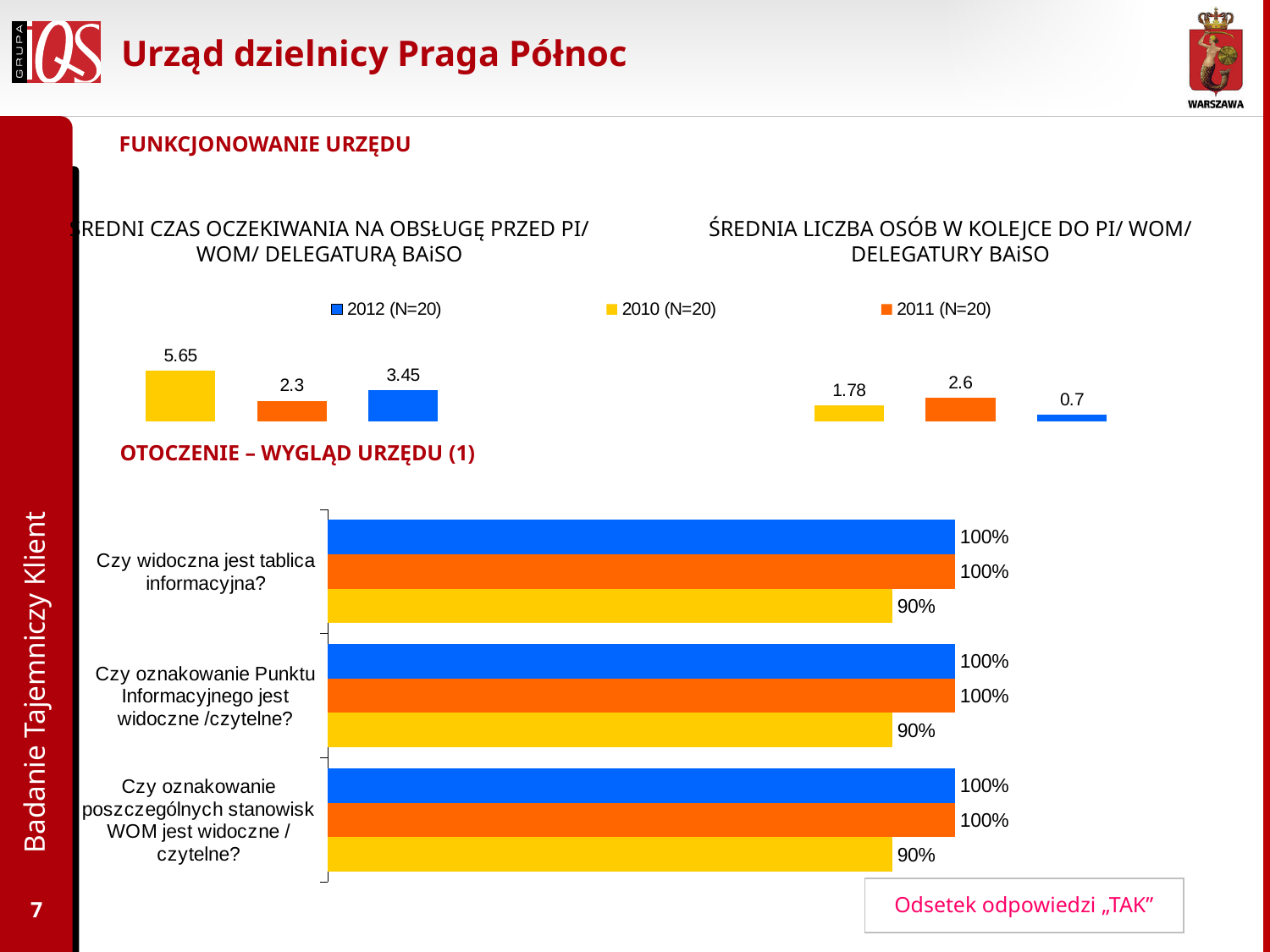
In the chart titled "ŚREDNIA LICZBA OSÓB W KOLEJCE DO PI/ WOM/ DELEGATURY BAiSO", what is the difference between the 2011 value and the 2012 value? 1.9 In the chart titled "ŚREDNI CZAS OCZEKIWANIA NA OBSŁUGĘ PRZED PI/ WOM/ DELEGATURĄ BAiSO", what is the difference between the 2010 value and the 2011 value? 3.35 In the bottom chart under "OTOCZENIE – WYGLĄD URZĘDU (1)", what is the value for 2010 (N=20) for "Czy widoczna jest tablica informacyjna?"? 90% In the chart titled "ŚREDNI CZAS OCZEKIWANIA NA OBSŁUGĘ PRZED PI/ WOM/ DELEGATURĄ BAiSO", what is the value for 2012 (N=20)? 3.45 In the chart titled "ŚREDNIA LICZBA OSÓB W KOLEJCE DO PI/ WOM/ DELEGATURY BAiSO", is the value for 2010 larger or smaller than the value for 2012? larger In the chart titled "ŚREDNI CZAS OCZEKIWANIA NA OBSŁUGĘ PRZED PI/ WOM/ DELEGATURĄ BAiSO", what is the value for 2010 (N=20)? 5.65 In the chart titled "ŚREDNIA LICZBA OSÓB W KOLEJCE DO PI/ WOM/ DELEGATURY BAiSO", what is the value for 2011 (N=20)? 2.6 What type of chart is the bottom chart under "OTOCZENIE – WYGLĄD URZĘDU (1)"? bar chart How many question categories are shown in the bottom chart under "OTOCZENIE – WYGLĄD URZĘDU (1)"? 3 In the bottom chart under "OTOCZENIE – WYGLĄD URZĘDU (1)", what is the value for 2012 (N=20) for "Czy oznakowanie Punktu Informacyjnego jest widoczne /czytelne?"? 100% In the chart titled "ŚREDNI CZAS OCZEKIWANIA NA OBSŁUGĘ PRZED PI/ WOM/ DELEGATURĄ BAiSO", which year has the lowest value? 2011 (N=20) In the chart titled "ŚREDNIA LICZBA OSÓB W KOLEJCE DO PI/ WOM/ DELEGATURY BAiSO", which year has the highest value? 2011 (N=20)